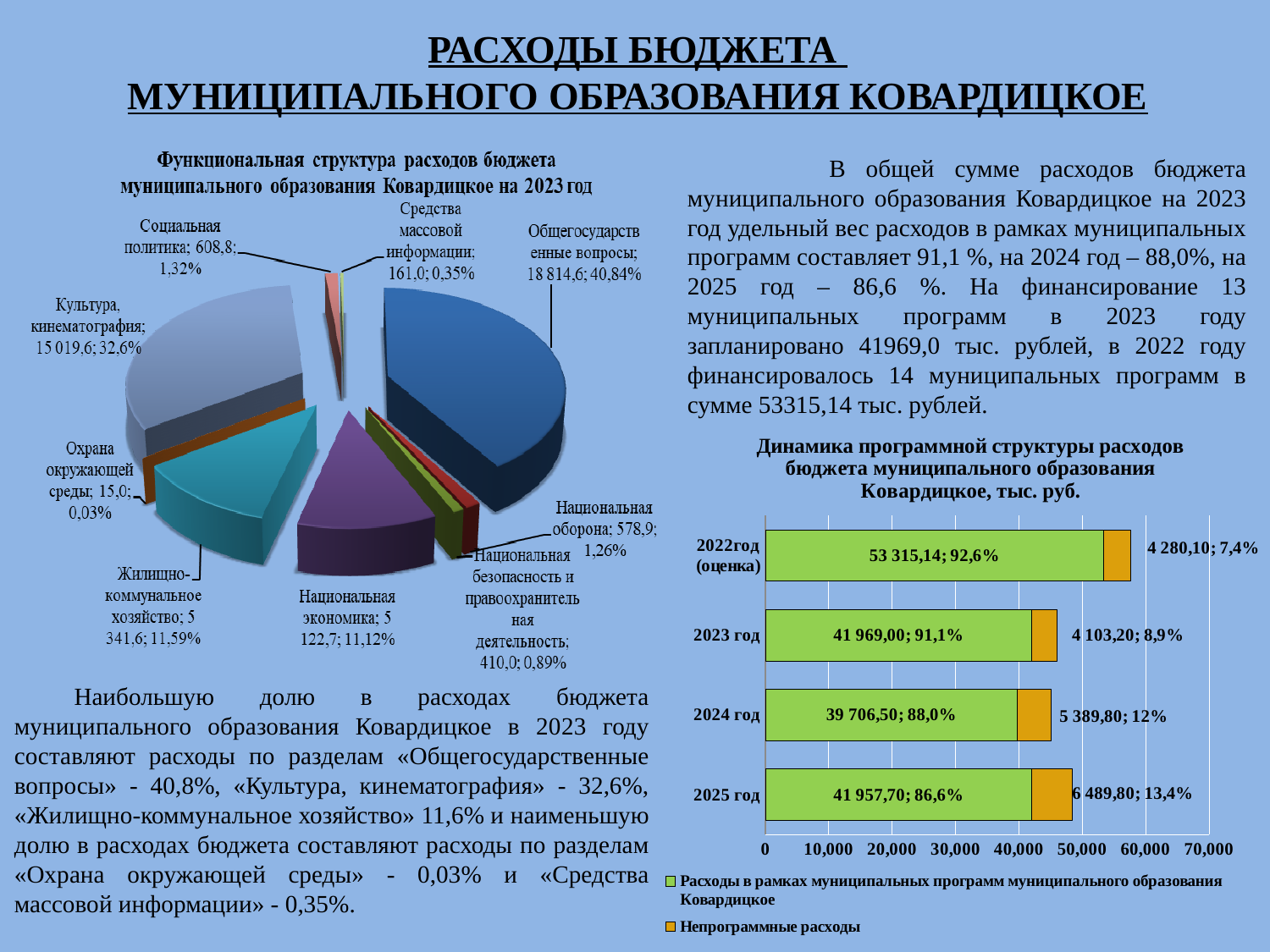
In the pie chart 'Функциональная структура расходов бюджета', which is larger: Жилищно-коммунальное хозяйство or Национальная экономика? Жилищно-коммунальное хозяйство In the pie chart 'Функциональная структура расходов бюджета', which category has the smallest share? Охрана окружающей среды In the bar chart 'Динамика программной структуры расходов', what is the total of the stacked bar for 2023 год? 46 072,20 In the bar chart 'Динамика программной структуры расходов', what is the value of Расходы в рамках муниципальных программ for 2024 год? 39 706,50; 88,0% In the bar chart 'Динамика программной структуры расходов', what is the difference between Непрограммные расходы in 2025 год and 2023 год? 2 386,60 In the bar chart 'Динамика программной структуры расходов', what is the value of Непрограммные расходы for 2025 год? 6 489,80; 13,4% In the pie chart 'Функциональная структура расходов бюджета', how many categories are shown? 9 What type of chart is 'Динамика программной структуры расходов бюджета муниципального образования Ковардицкое'? Stacked bar chart In the pie chart 'Функциональная структура расходов бюджета', what share does Культура, кинематография have? 32,6% In the pie chart 'Функциональная структура расходов бюджета', what value is shown for Общегосударственные вопросы? 18 814,6; 40,84% In the pie chart 'Функциональная структура расходов бюджета', which category has the largest share? Общегосударственные вопросы In the bar chart 'Динамика программной структуры расходов', how many series does the legend list? 2